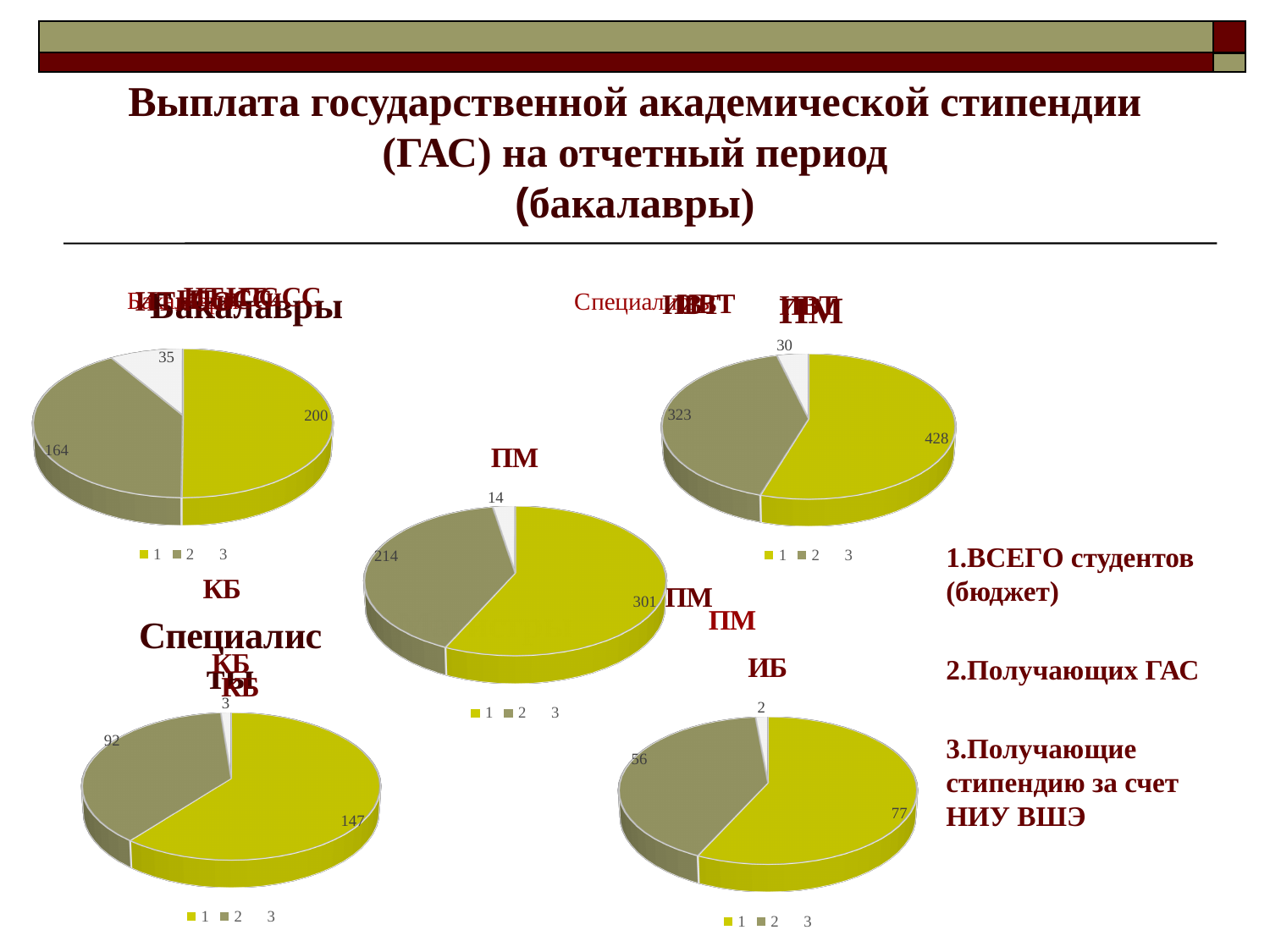
In the top-left pie chart, what is the difference between the two largest slices (200 and 164)? 36 In the bottom-right pie chart titled ИБ, what is the value of the largest slice? 77 How many pie charts are on the slide? 5 In the bottom-left pie chart, what is the value of the smallest slice? 3 How many entries does the legend of each pie chart list? 3 In the top-right pie chart, what is the difference between the slices labelled 428 and 323? 105 In the center pie chart titled ПМ, what is the value of the second slice (legend entry 2)? 214 What type of charts are shown on the slide? pie chart In the top-right pie chart, what is the value of the largest slice? 428 In the center pie chart titled ПМ, what is the total of all three slices? 529 In the top-left pie chart, what is the value of the smallest slice? 35 In the top-left pie chart, what is the value of the largest slice? 200